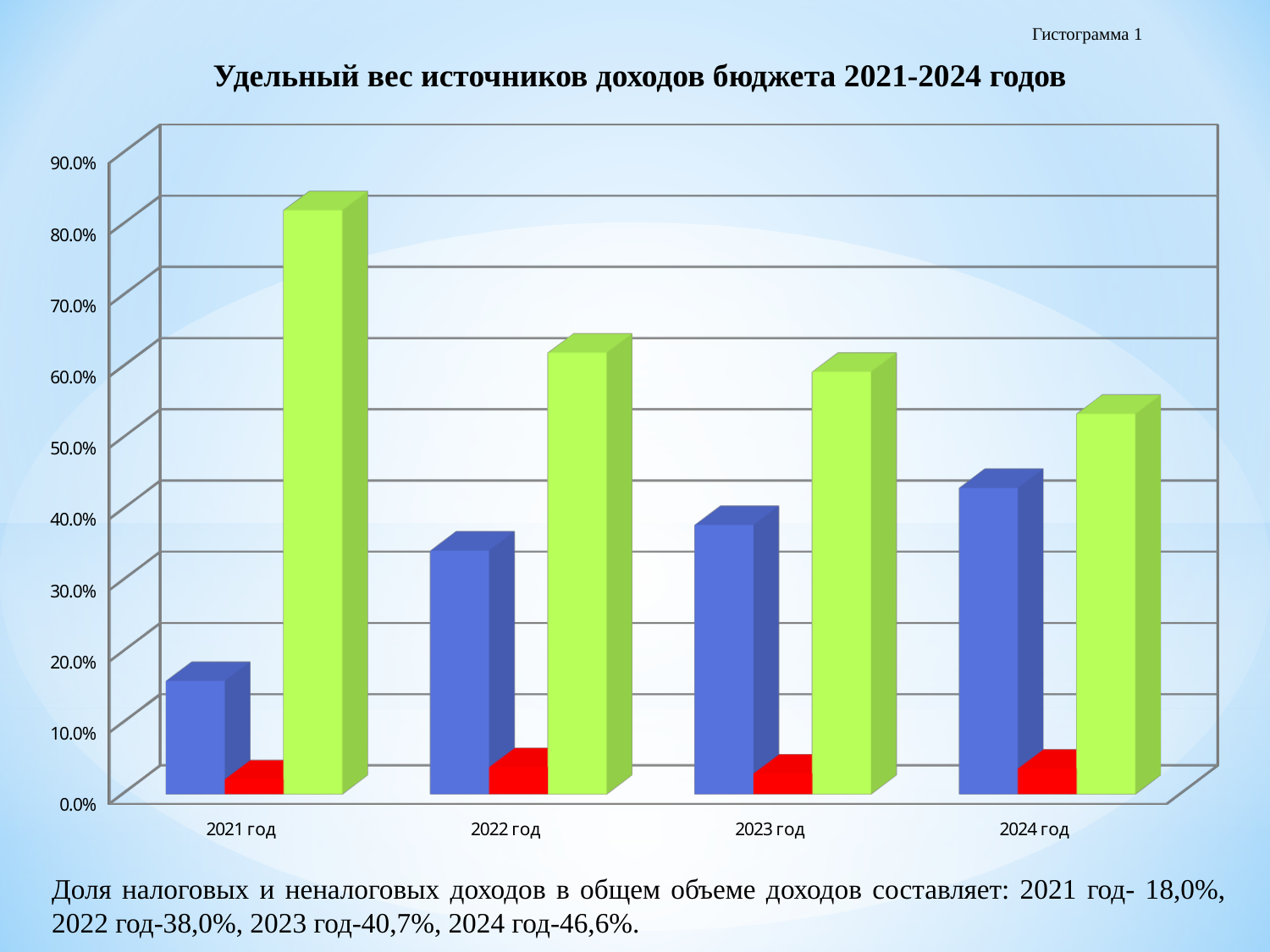
Is the green bar for 2021 год greater or less than 70.0%? greater How many year categories are shown on the x axis? 4 Do the green bars rise or fall from 2021 год to 2024 год? fall For 2024 год, which is larger, the blue bar or the green bar? the green bar What kind of chart is shown on the slide? bar chart How many bars are plotted for each year? 3 Is the blue bar for 2021 год greater or less than 20.0%? less Do the blue bars rise or fall from 2021 год to 2024 год? rise What is the title of the chart? Удельный вес источников доходов бюджета 2021-2024 годов In which year is the blue bar the lowest? 2021 год Is the red bar for 2023 год greater or less than 10.0%? less In which year is the green bar the highest? 2021 год